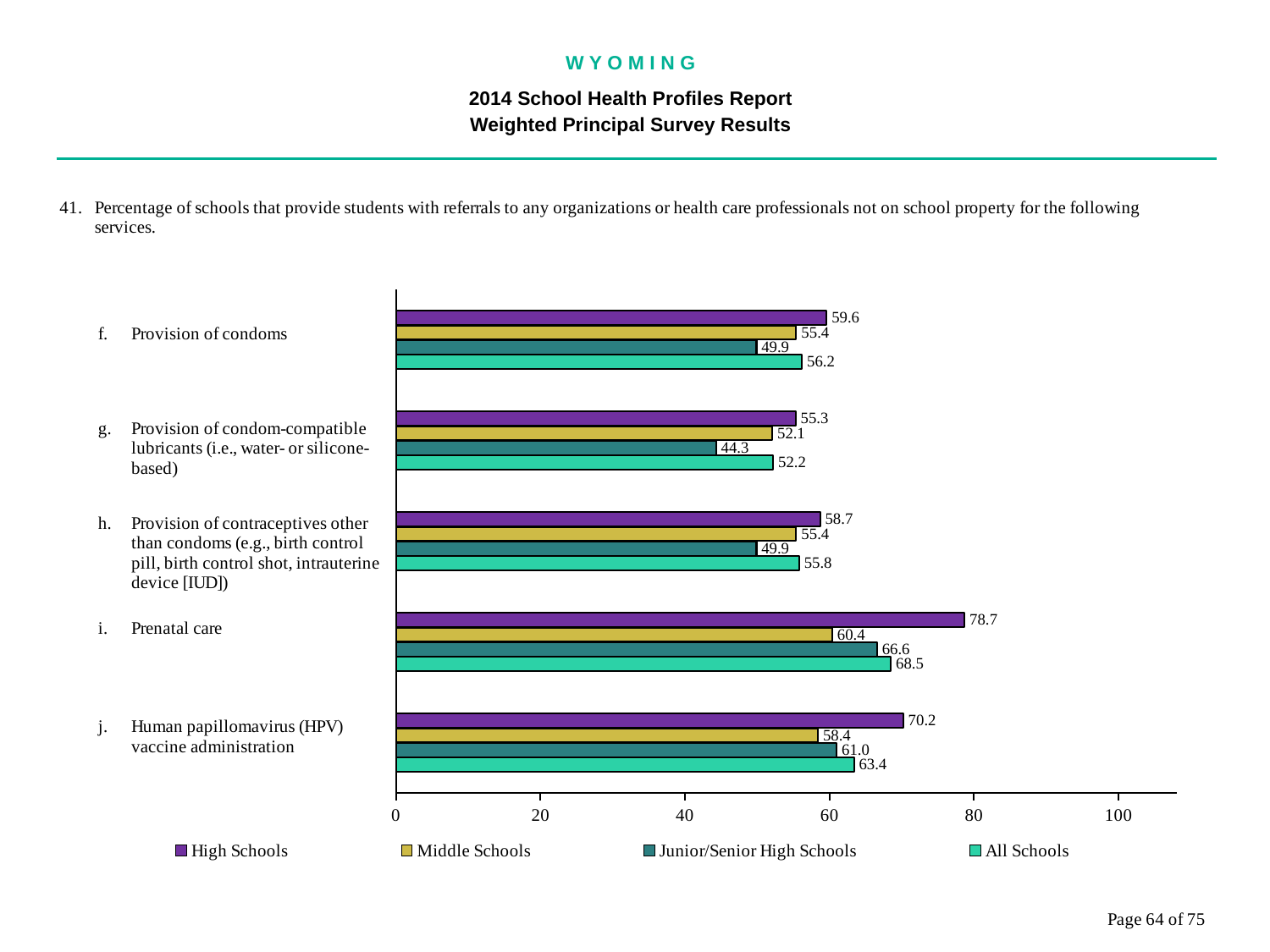
What kind of chart is shown on the slide? Bar chart What is the value for High Schools for Prenatal care? 78.7 What is the value for Junior/Senior High Schools for Provision of condom-compatible lubricants? 44.3 What is the value for Middle Schools for Provision of condoms? 55.4 Which service has the lowest value for Junior/Senior High Schools? Provision of condom-compatible lubricants What is the value for All Schools for Human papillomavirus (HPV) vaccine administration? 63.4 How many series does the legend list? 4 How many services (categories) are shown in the chart? 5 Which service has the highest value for High Schools? Prenatal care For Human papillomavirus (HPV) vaccine administration, which is larger: the Middle Schools value or the Junior/Senior High Schools value? Junior/Senior High Schools Which series is shown in purple in the legend? High Schools What is the difference between the High Schools and Middle Schools values for Prenatal care? 18.3